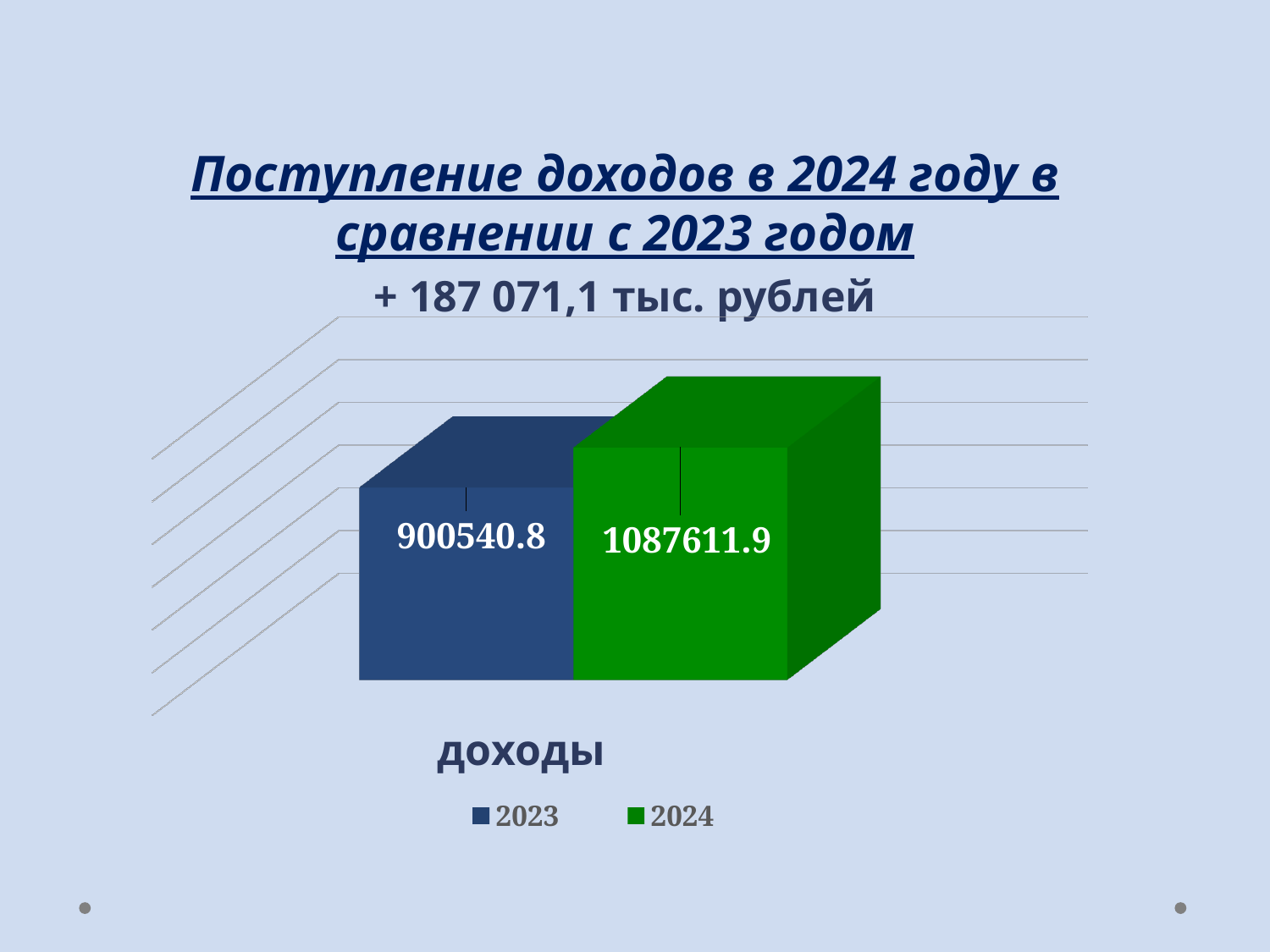
Which series has the lowest value in the chart? 2023 What is the difference between the 2024 value and the 2023 value? 187071.1 Which series has the highest value in the chart? 2024 What is the value for 2024 in the chart? 1087611.9 What kind of chart is shown on the slide? bar chart How many categories are shown on the x axis? 1 Which year has the higher value, 2023 or 2024? 2024 How many series does the legend list? 2 Which colour represents the 2024 series in the legend? green What is the value for 2023 in the chart? 900540.8 Does the value increase or decrease from 2023 to 2024? increase What is the category label shown on the x axis? доходы